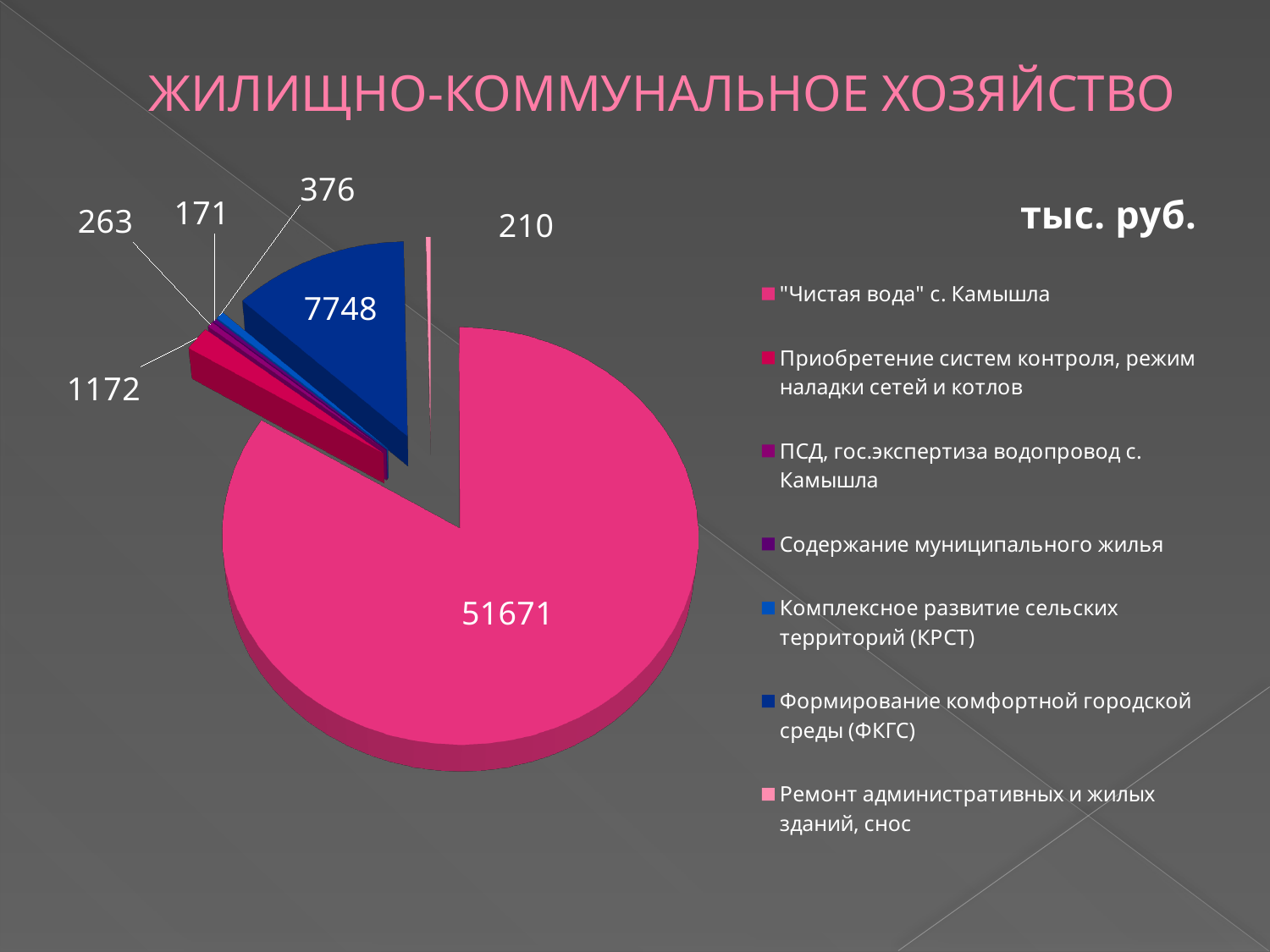
What is the value for "Чистая вода" с. Камышла? 51671 What is the value for Комплексное развитие сельских территорий (КРСТ)? 376 Which is larger: the value for Комплексное развитие сельских территорий (КРСТ) or the value for ПСД, гос.экспертиза водопровод с. Камышла? Комплексное развитие сельских территорий (КРСТ) Which category has the largest slice of the pie? "Чистая вода" с. Камышла What unit is indicated for the values on the chart? тыс. руб. What is the value for Формирование комфортной городской среды (ФКГС)? 7748 What kind of chart is shown on the slide? pie chart How many categories does the legend list? 7 What is the difference between the values for Формирование комфортной городской среды (ФКГС) and Приобретение систем контроля, режим наладки сетей и котлов? 6576 Which category has the smallest value? Содержание муниципального жилья What is the value for Ремонт административных и жилых зданий, снос? 210 What is the value for Приобретение систем контроля, режим наладки сетей и котлов? 1172